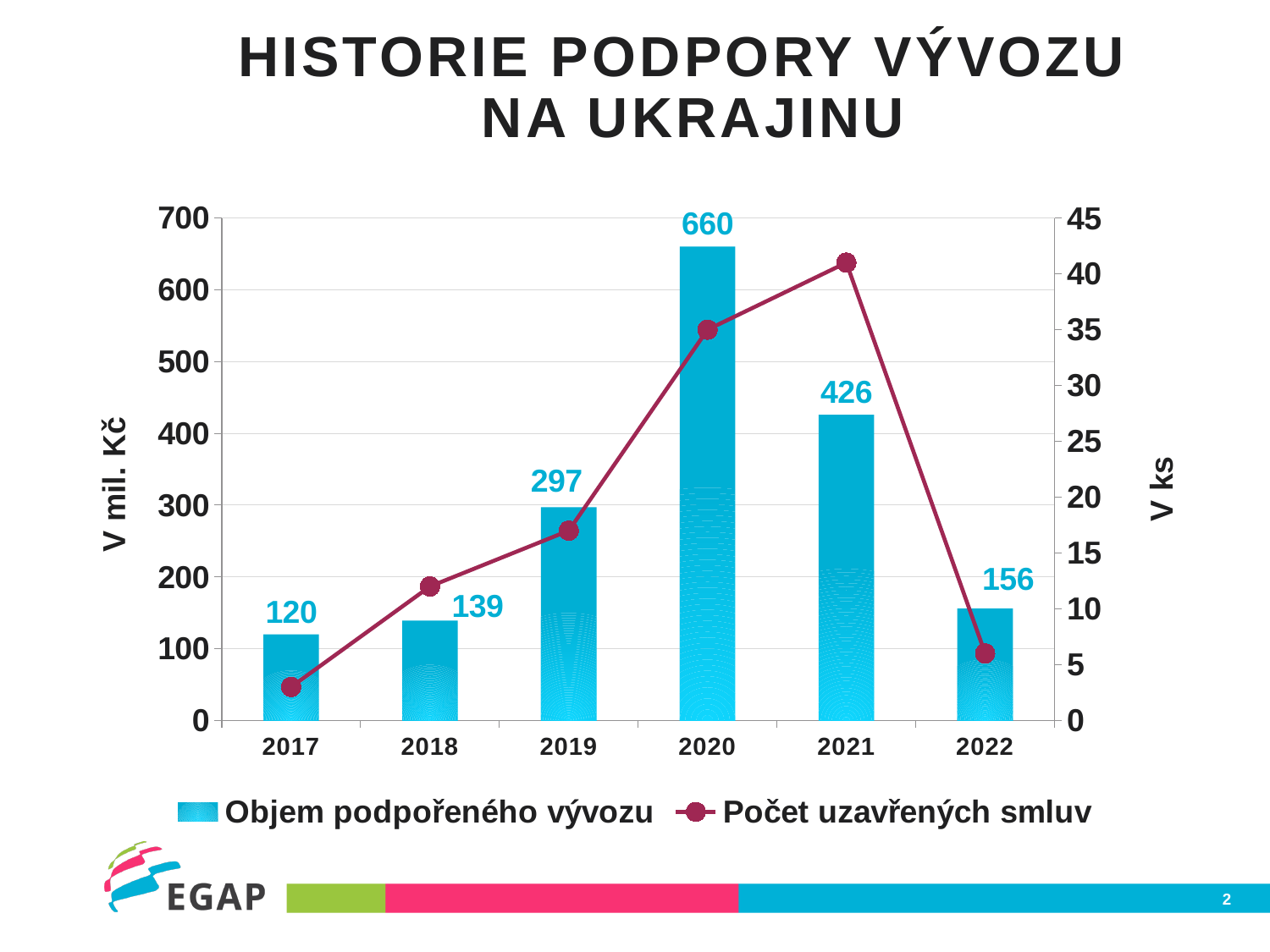
What is the label of the right-hand vertical axis? V ks Which is larger, Objem podpořeného vývozu in 2019 or in 2022? 2019 Is the value of Počet uzavřených smluv for 2021 greater or less than 35? greater How many years are shown on the x axis? 6 What is the difference between Objem podpořeného vývozu in 2020 and 2021? 234 How many series does the legend list? 2 Which year has the lowest Objem podpořeného vývozu? 2017 Is the value of Počet uzavřených smluv for 2017 greater or less than 5? less What is the value of Objem podpořeného vývozu for 2022? 156 What is the value of Objem podpořeného vývozu for 2020? 660 Which year has the highest Objem podpořeného vývozu? 2020 What is the value of Objem podpořeného vývozu for 2017? 120